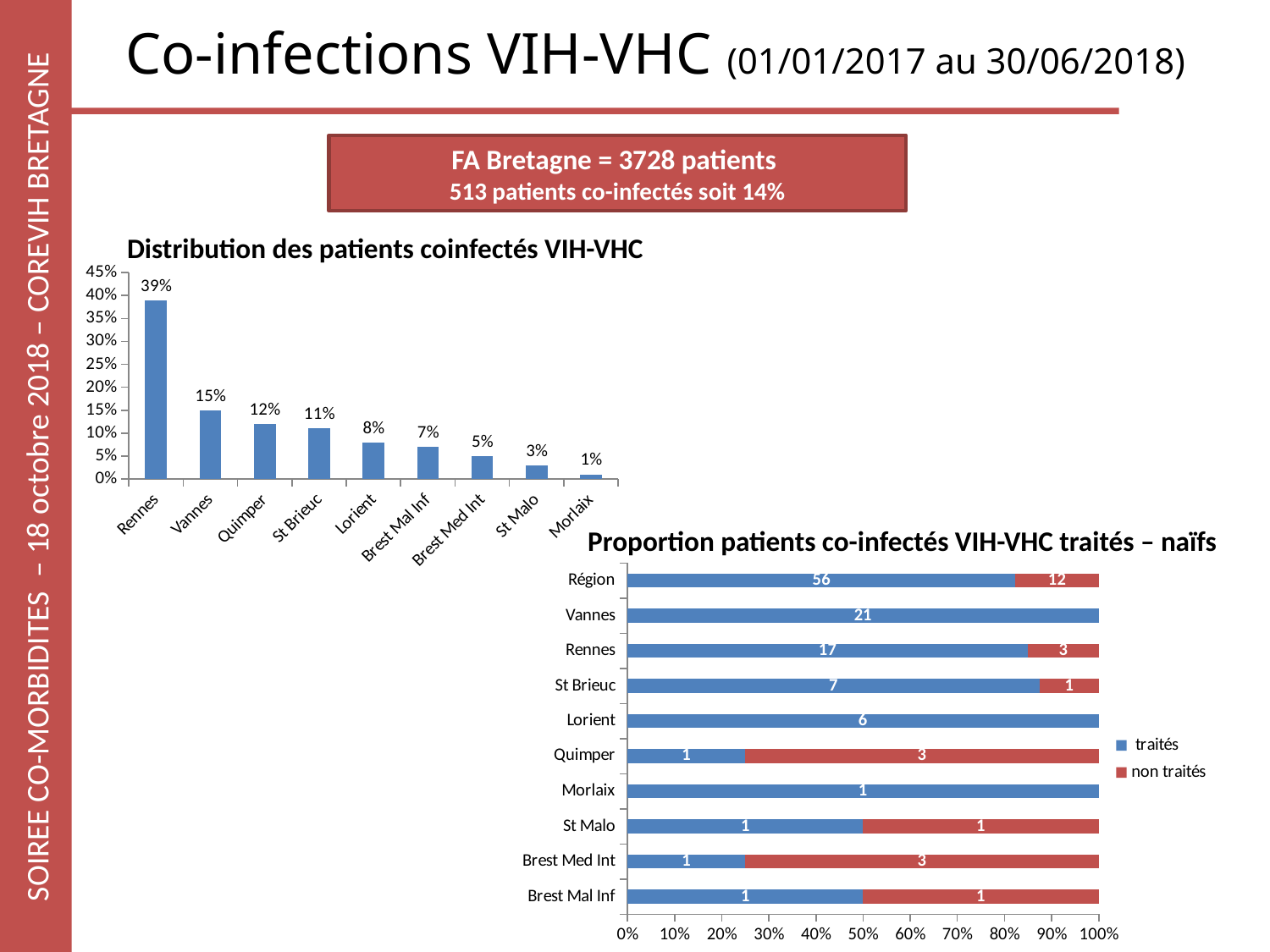
In the 'Proportion patients co-infectés VIH-VHC traités – naïfs' chart, which colour represents 'non traités'? red In the 'Proportion patients co-infectés VIH-VHC traités – naïfs' chart, how many 'traités' patients are shown for Région? 56 In the 'Distribution des patients coinfectés VIH-VHC' chart, which category has the lowest value? Morlaix In the 'Proportion patients co-infectés VIH-VHC traités – naïfs' chart, how many 'non traités' patients are shown for Rennes? 3 What kind of chart is 'Proportion patients co-infectés VIH-VHC traités – naïfs'? stacked bar chart In the 'Distribution des patients coinfectés VIH-VHC' chart, what is the value for Lorient? 8% In the 'Proportion patients co-infectés VIH-VHC traités – naïfs' chart, what is the total number of patients for St Brieuc? 8 In the 'Distribution des patients coinfectés VIH-VHC' chart, what is the value for Rennes? 39% In the 'Distribution des patients coinfectés VIH-VHC' chart, what is the difference between the values for Vannes and Quimper? 3% In the 'Distribution des patients coinfectés VIH-VHC' chart, how many categories are shown on the x axis? 9 In the 'Distribution des patients coinfectés VIH-VHC' chart, do the values rise or fall from left to right along the x axis? fall How many series does the legend of the 'Proportion patients co-infectés VIH-VHC traités – naïfs' chart list? 2